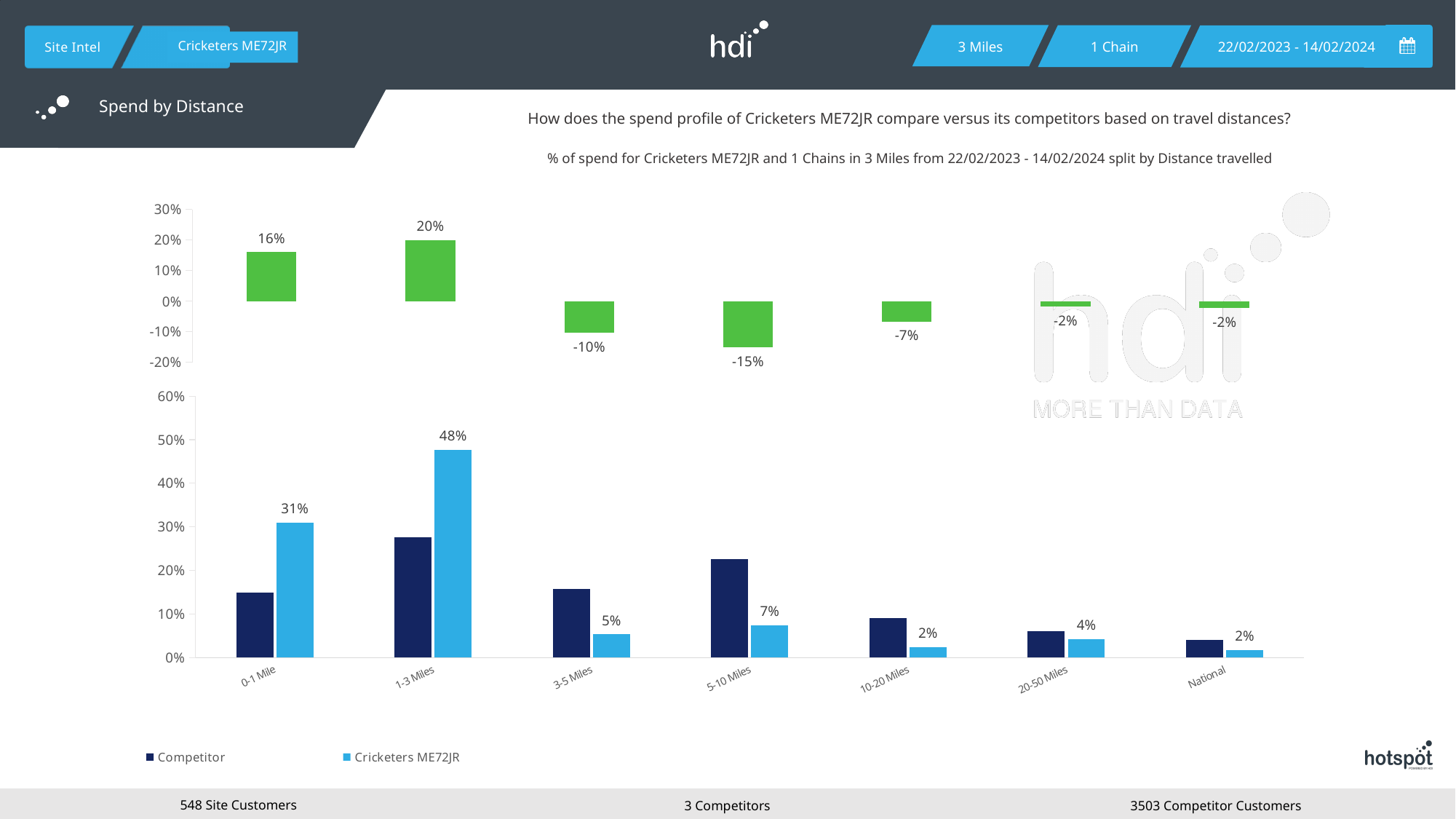
How many distance categories are shown on the x axis of the bottom chart? 7 In the bottom chart, which category has the highest value for Cricketers ME72JR? 1-3 Miles In the bottom chart, what is the value for Cricketers ME72JR in the 0-1 Mile category? 31% How many series does the legend of the bottom chart list? 2 In the top chart, what is the value shown for the 5-10 Miles category? -15% What type of chart is the bottom chart? Bar chart In the bottom chart, what is the difference between the Cricketers ME72JR values for 1-3 Miles and 0-1 Mile? 17% In the bottom chart, is the Competitor value for 5-10 Miles greater or less than 20%? greater In the bottom chart, what is the value for Cricketers ME72JR in the 1-3 Miles category? 48% In the bottom chart, which is larger for 3-5 Miles: the Competitor value or the Cricketers ME72JR value? Competitor In the top chart, which category has the highest value? 1-3 Miles In the top chart, which category has the lowest value? 5-10 Miles